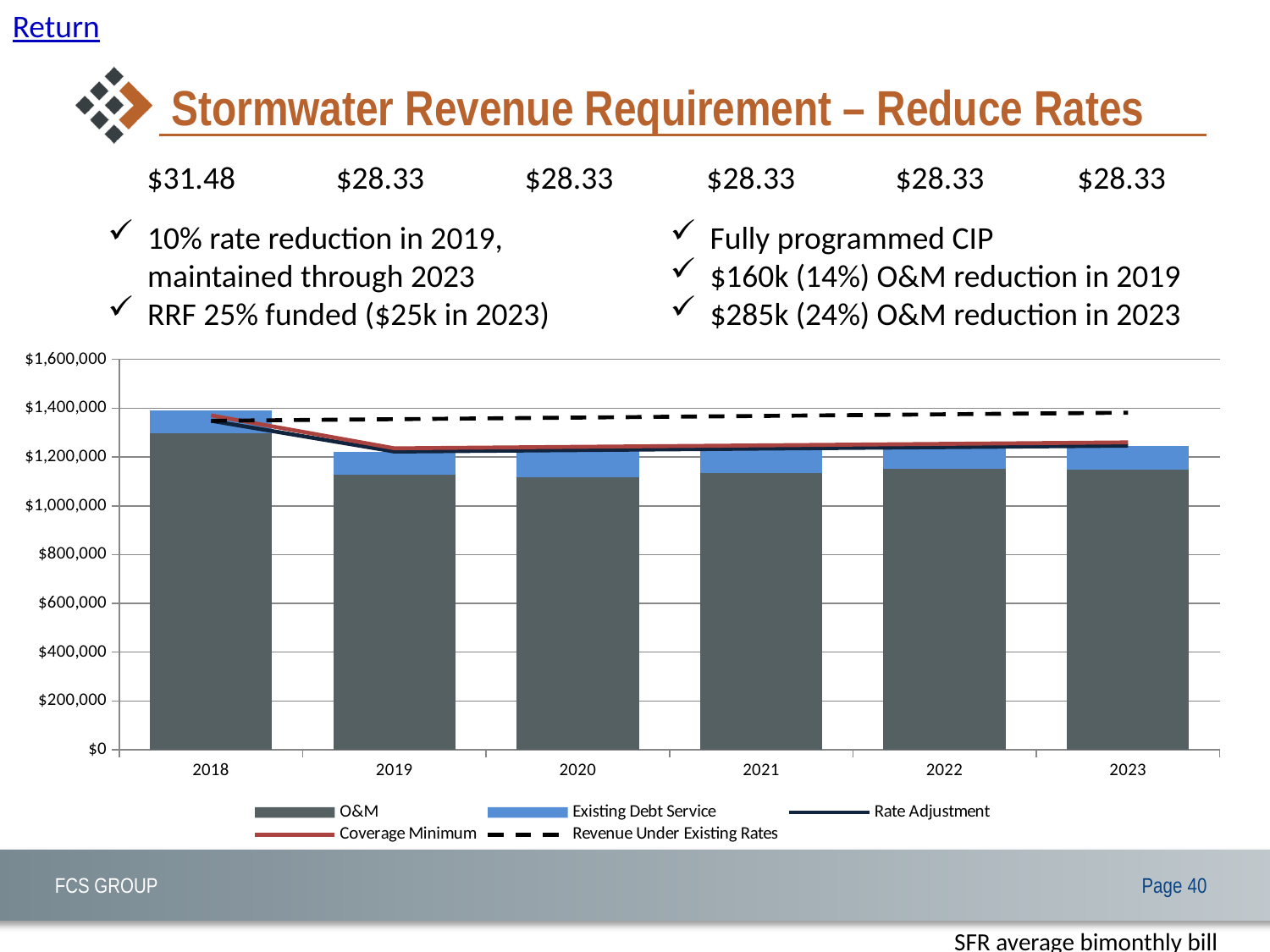
Is the O&M value for 2019 greater or less than $1,200,000? less Which legend series is drawn as a dashed line? Revenue Under Existing Rates What kind of chart is shown on the slide? Stacked bar chart with line series How many years are shown on the x axis of the chart? 6 How many series does the chart legend list? 5 Is the O&M value for 2018 greater or less than $1,200,000? greater Which is larger, the O&M value for 2018 or the O&M value for 2019? 2018 Which year has the highest O&M value? 2018 Is the total stacked bar for 2020 greater or less than $1,400,000? less Which year has the tallest stacked bar in the chart? 2018 Does the total stacked bar rise or fall from 2018 to 2019? fall